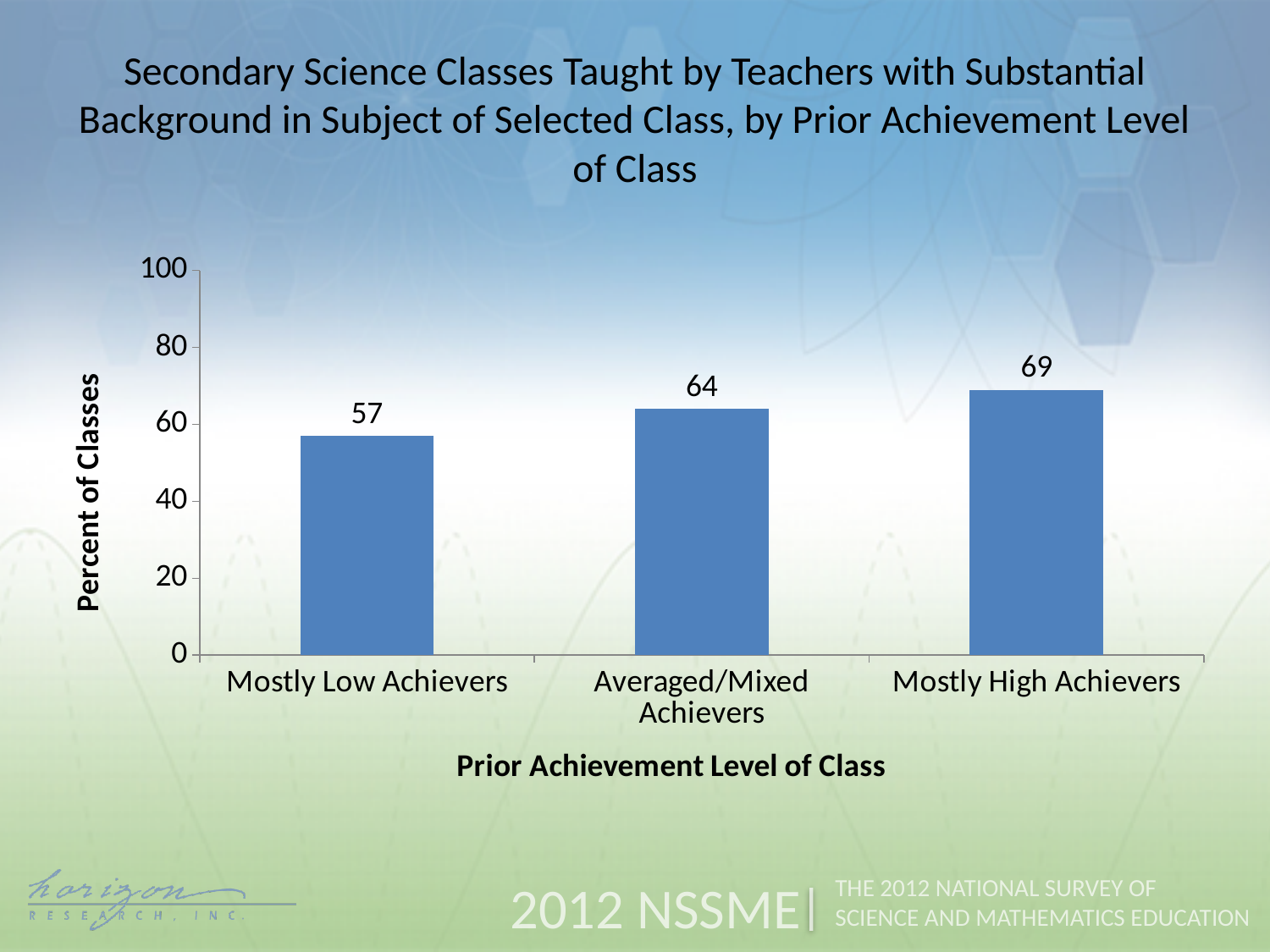
What kind of chart is shown on the slide? bar chart Which prior achievement level has the lowest percent of classes? Mostly Low Achievers Which prior achievement level has the highest percent of classes? Mostly High Achievers What is the difference between the values for Averaged/Mixed Achievers and Mostly Low Achievers? 7 What is the difference between the values for Mostly High Achievers and Mostly Low Achievers? 12 Do the values rise or fall from Mostly Low Achievers to Mostly High Achievers? rise How many categories are shown on the x axis? 3 Is the value for Mostly Low Achievers greater or less than 60? less What is the value for Mostly Low Achievers? 57 Which is larger, the value for Averaged/Mixed Achievers or the value for Mostly High Achievers? Mostly High Achievers What is the value for Averaged/Mixed Achievers? 64 What is the value for Mostly High Achievers? 69